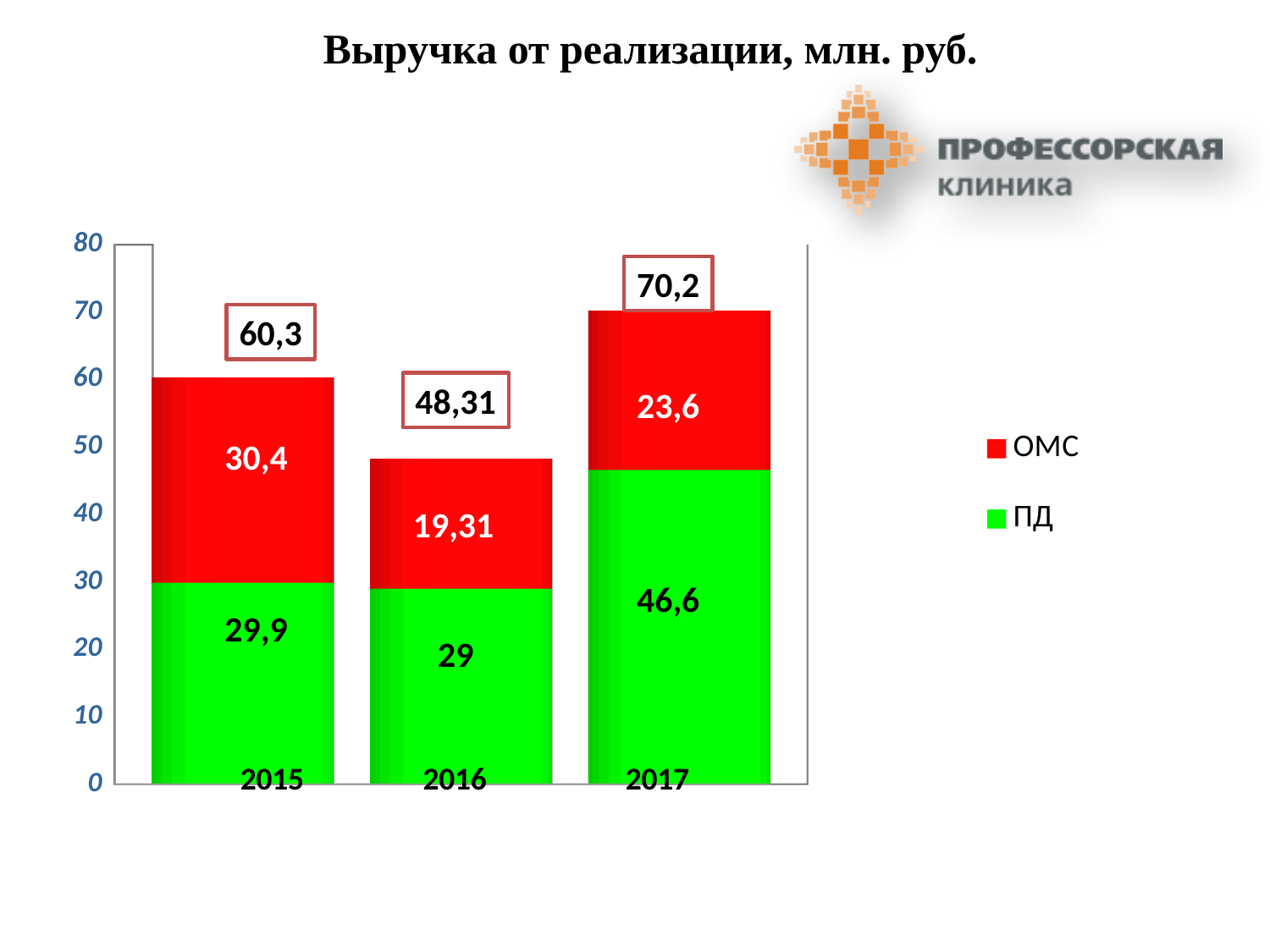
What kind of chart is shown on the slide? Stacked bar chart Which year has the highest total revenue? 2017 What is the total of the stacked bar for 2016? 48,31 Which year has the lowest total revenue? 2016 How many years are shown on the x axis? 3 Which is larger in 2017, the ОМС value or the ПД value? ПД What is the difference between the ПД values for 2017 and 2016? 17,6 What is the value for ПД in 2016? 29 What is the value for ОМС in 2015? 30,4 What is the value for ОМС in 2017? 23,6 What is the total of the stacked bar for 2017? 70,2 How many series does the legend list? 2